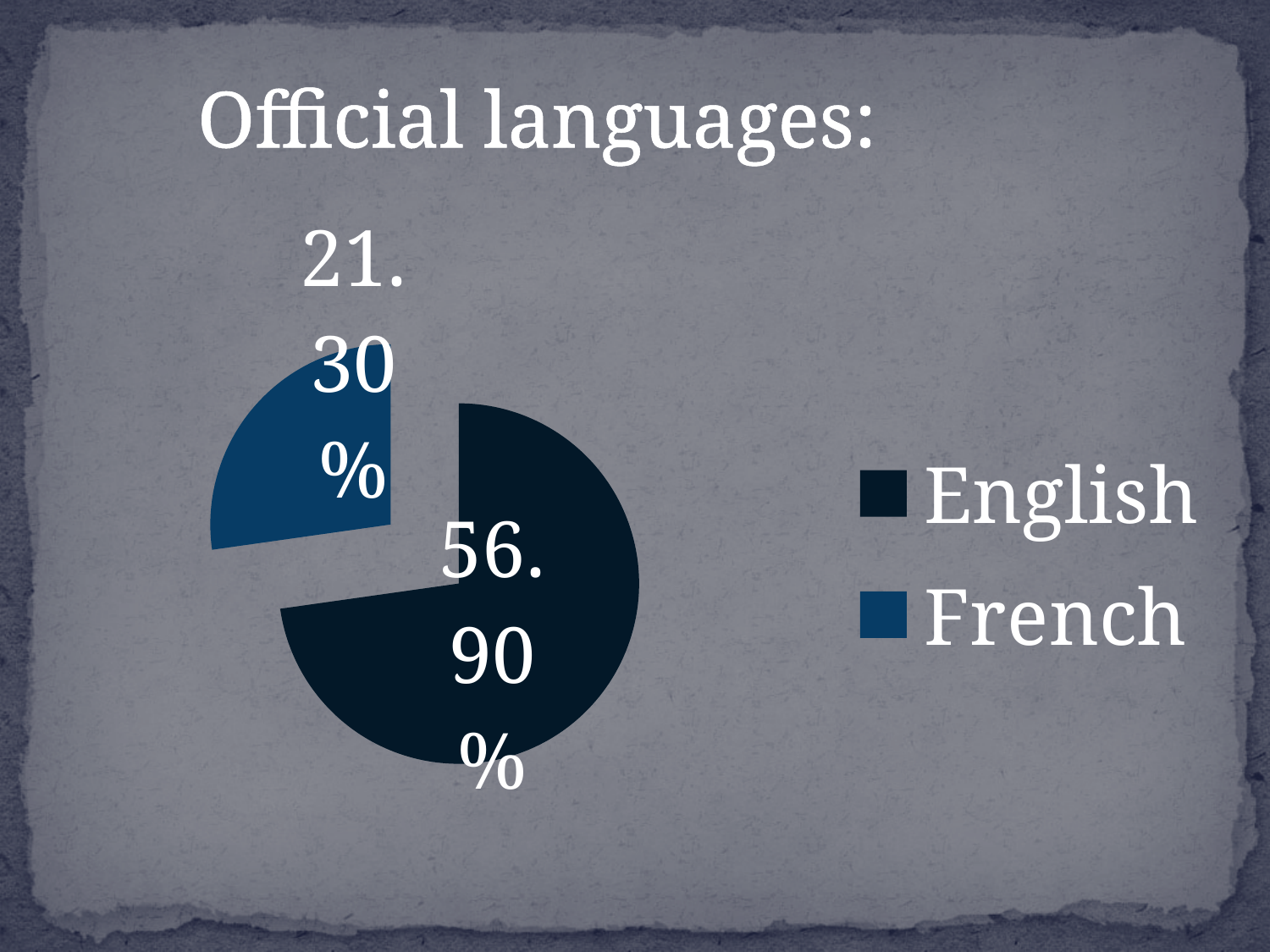
What is the difference between the English value and the French value? 35.60% How many slices does the pie chart have? 2 What share of the pie does the French slice represent? 21.30% What is the title of the slide? Official languages: What is the value shown for French in the pie chart? 21.30% Which language has the smallest slice of the pie chart? French Which is larger, the value for English or the value for French? English How many entries does the legend list? 2 Which languages are listed in the legend? English and French What is the value shown for English in the pie chart? 56.90% Which language has the largest slice of the pie chart? English What kind of chart is shown on the slide? Pie chart